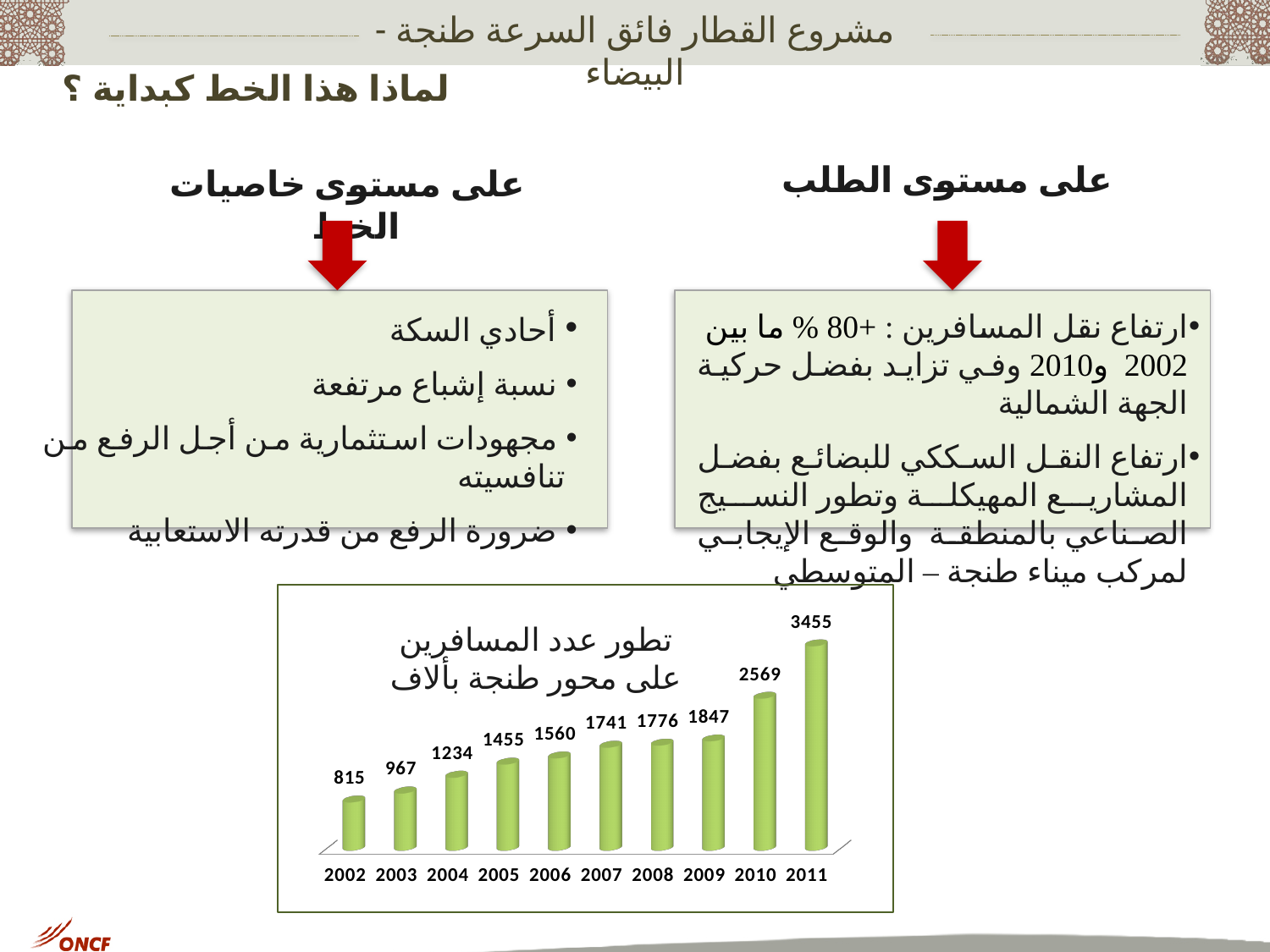
What is the value for 2010 in the chart? 2569 Which year has the lowest value in the chart? 2002 Do the values rise or fall from 2002 to 2011 along the x axis? Rise Which year has the highest value in the chart? 2011 Which is larger, the value for 2008 or the value for 2009? 2009 What type of chart is shown on the slide? Bar chart How many years are shown on the x axis of the chart? 10 What is the value for 2007 in the chart? 1741 What is the difference between the values for 2003 and 2002? 152 What is the difference between the values for 2011 and 2010? 886 What is the value for 2011 in the chart? 3455 What is the value for 2002 in the chart? 815